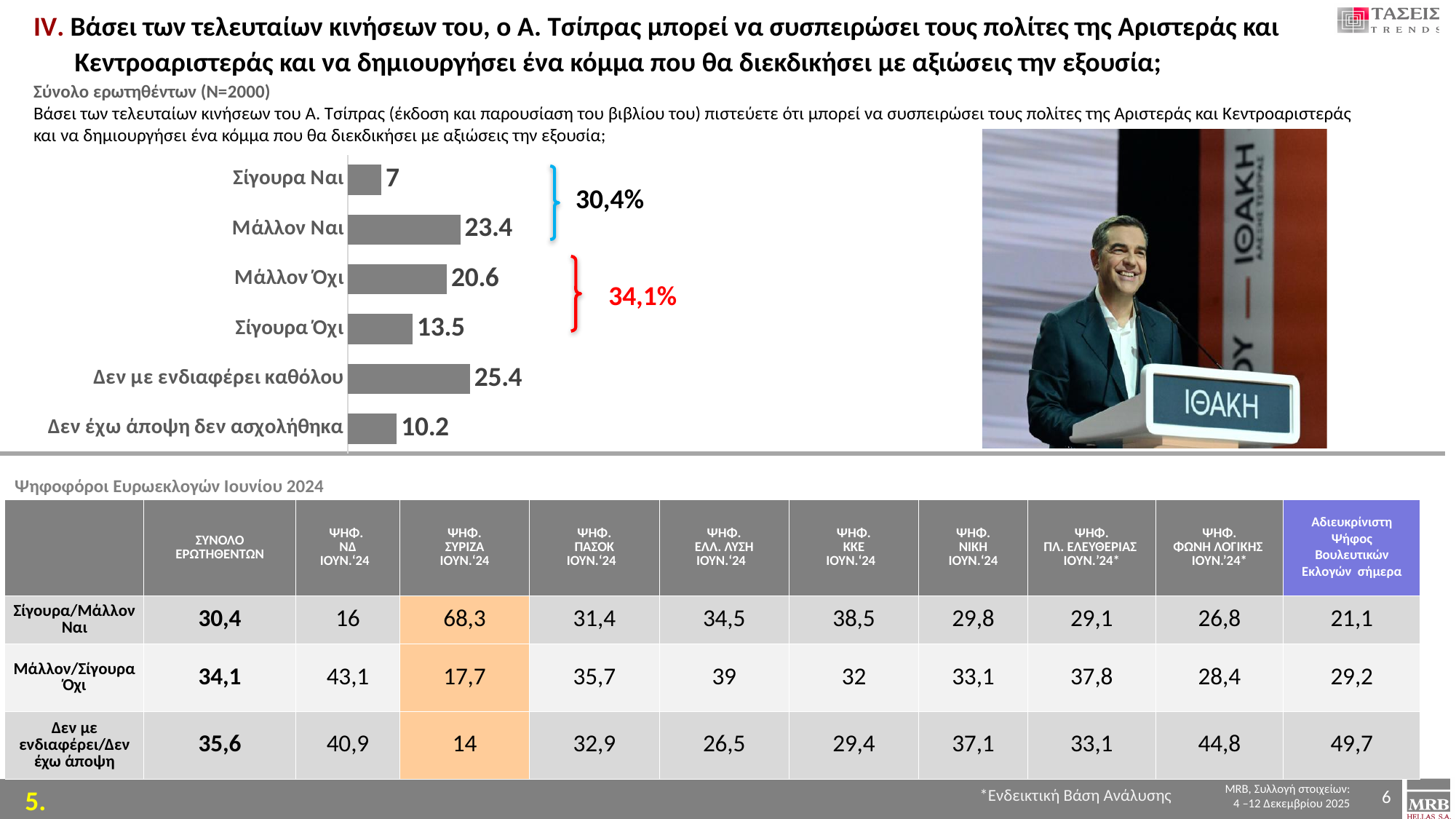
Which category has the highest value in the bar chart? Δεν με ενδιαφέρει καθόλου What is the combined value of "Σίγουρα Ναι" and "Μάλλον Ναι" as annotated next to the bar chart? 30,4% What is the difference between the values for "Μάλλον Ναι" and "Μάλλον Όχι" in the bar chart? 2.8 How many categories are shown in the bar chart? 6 In the bar chart, which is larger: the value for "Σίγουρα Όχι" or the value for "Δεν έχω άποψη δεν ασχολήθηκα"? Σίγουρα Όχι What value does the bar chart show for "Σίγουρα Όχι"? 13.5 Which category has the lowest value in the bar chart? Σίγουρα Ναι What type of chart is shown on the slide? Bar chart What value does the bar chart show for "Δεν έχω άποψη δεν ασχολήθηκα"? 10.2 What is the combined value of "Μάλλον Όχι" and "Σίγουρα Όχι" as annotated next to the bar chart? 34,1% What is the difference between the values for "Δεν με ενδιαφέρει καθόλου" and "Σίγουρα Ναι" in the bar chart? 18.4 What value does the bar chart show for "Μάλλον Ναι"? 23.4